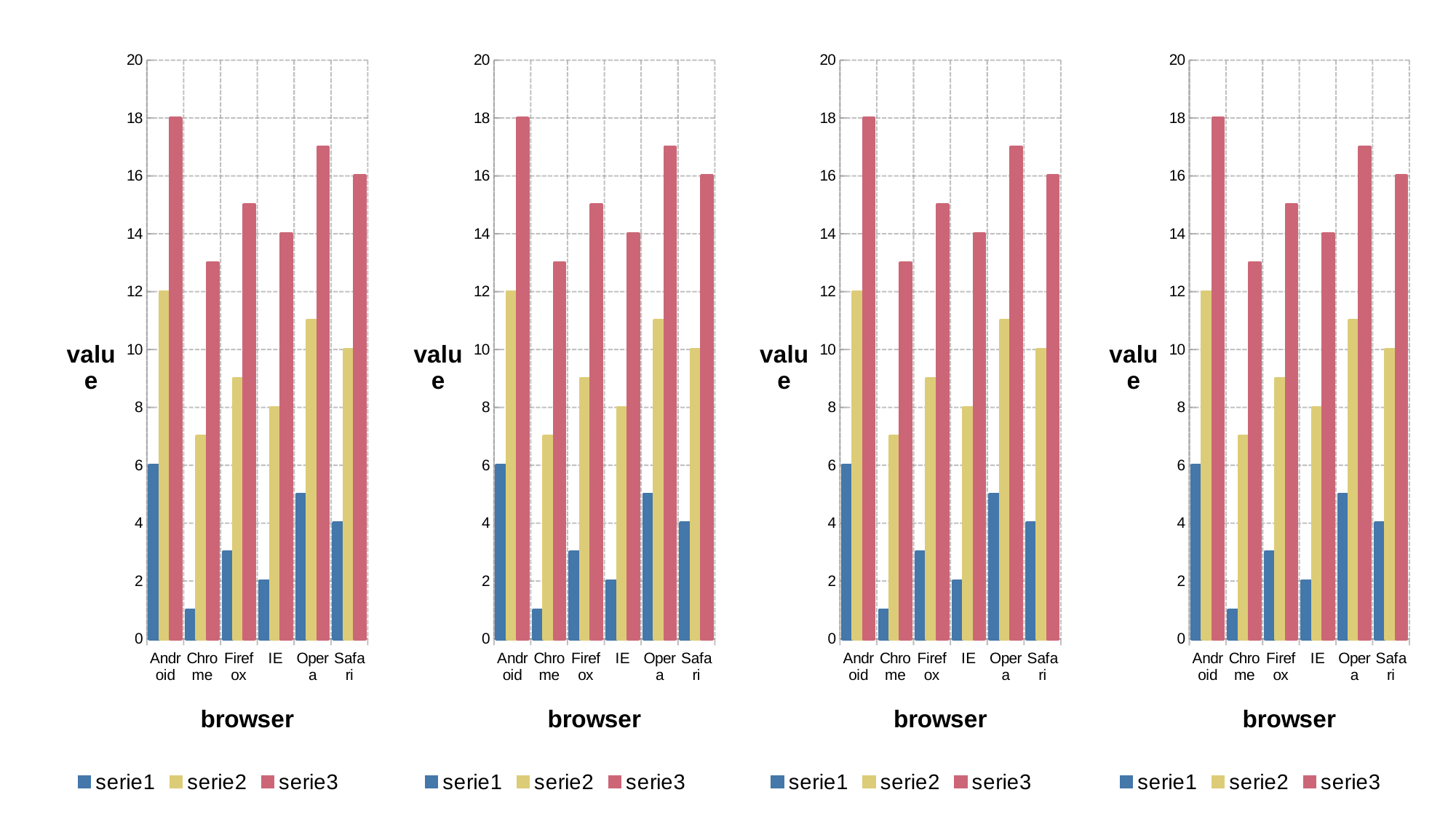
In the second chart from the left, what is the value of serie1 for IE? 2 In the third chart from the left, what is the value of serie2 for Safari? 10 How many series does the legend of the rightmost chart list? 3 How many browser categories are shown on the x axis of the second chart from the left? 6 In the leftmost chart, what is the value of serie3 for Android? 18 In the leftmost chart, is the value of serie2 for Chrome greater or less than 8? less In the leftmost chart, which browser has the lowest serie1 value? Chrome In the rightmost chart, is the value of serie3 for Opera greater or less than 16? greater In the second chart from the left, what is the difference between the serie3 and serie1 values for Android? 12 What type of chart is the leftmost chart? bar chart In the third chart from the left, which is larger: serie2 for Android or serie2 for IE? serie2 for Android In the rightmost chart, which browser has the highest serie3 value? Android